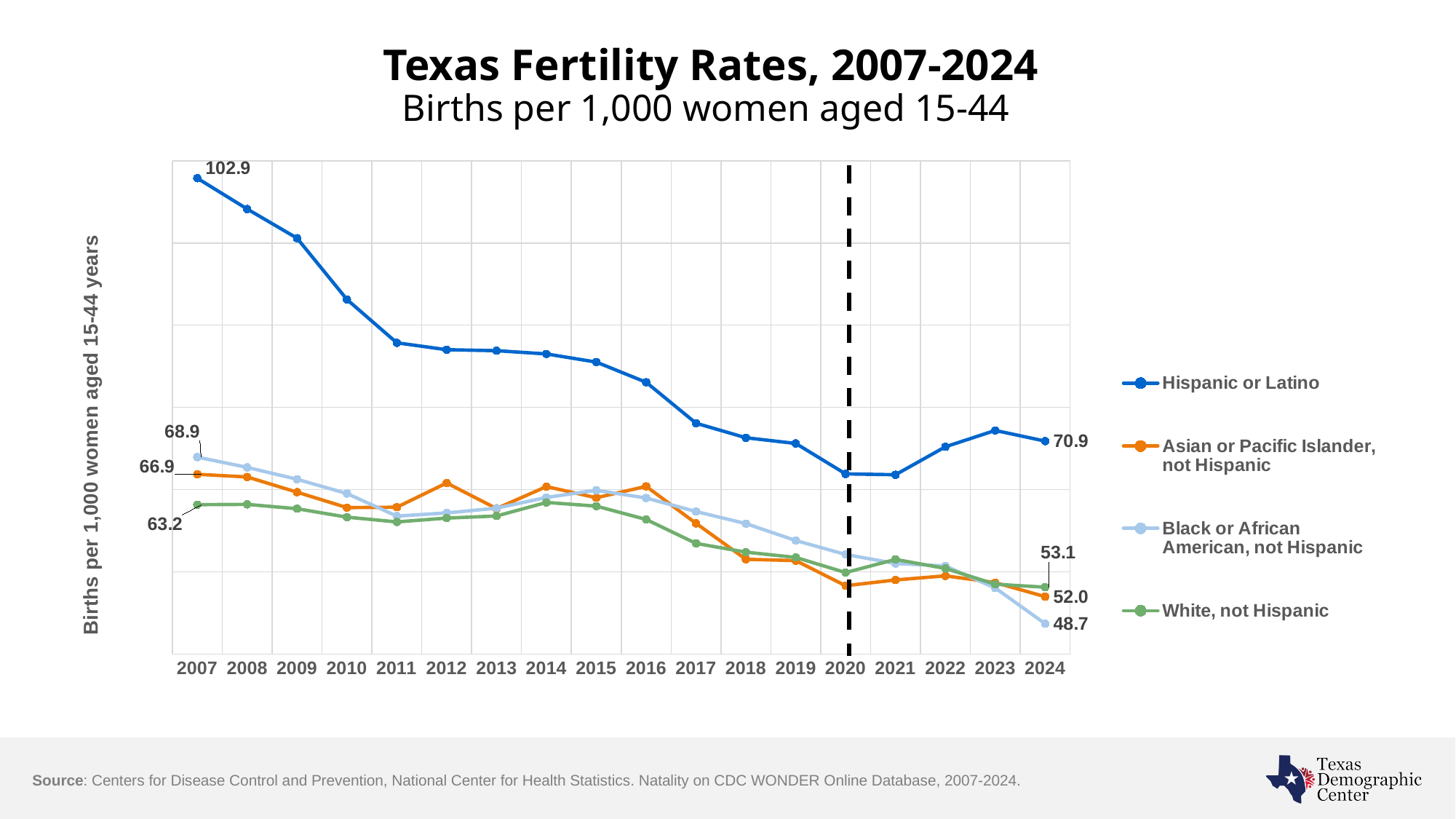
What is the fertility rate for White, not Hispanic women in 2007? 63.2 By how much did the Hispanic or Latino fertility rate fall from 2007 to 2024? 32.0 Does the Hispanic or Latino fertility rate rise or fall overall from 2007 to 2024? Fall What is the fertility rate for Black or African American, not Hispanic women in 2024? 48.7 How many years are plotted along the x axis? 18 Which group has the lowest fertility rate in 2024? Black or African American, not Hispanic What type of chart is shown on the slide? Line chart What is the fertility rate for Hispanic or Latino women in 2024? 70.9 In 2024, which is larger: the rate for White, not Hispanic women or for Asian or Pacific Islander, not Hispanic women? White, not Hispanic How many series does the legend list? 4 Which group has the highest fertility rate in 2007? Hispanic or Latino What is the fertility rate for Hispanic or Latino women in 2007? 102.9